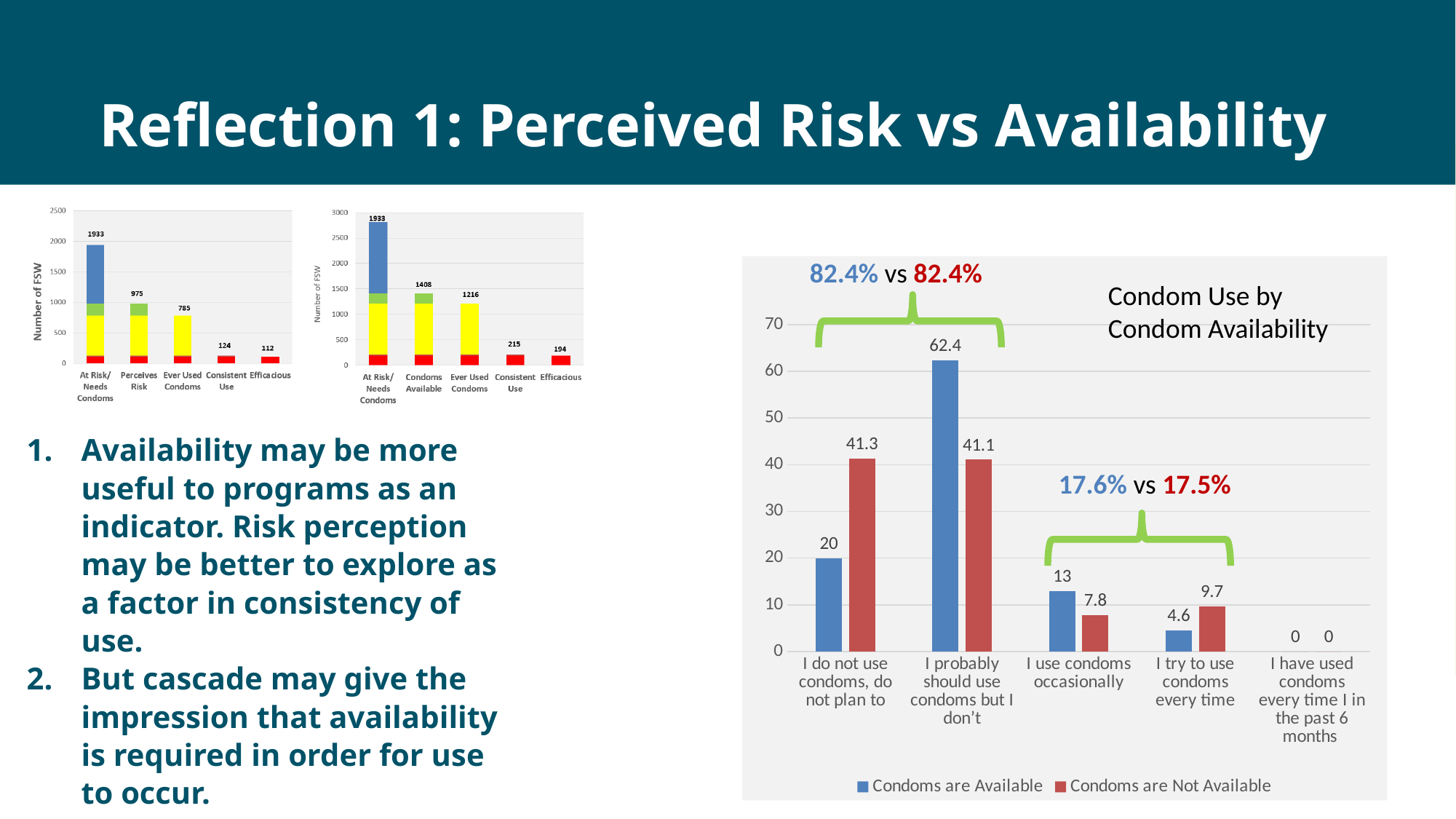
In the chart titled 'Condom Use by Condom Availability', for 'I try to use condoms every time', which series has the larger value? Condoms are Not Available In the chart titled 'Condom Use by Condom Availability', which category has the highest value in the 'Condoms are Available' series? I probably should use condoms but I don't In the chart titled 'Condom Use by Condom Availability', what is the difference between the 'Condoms are Available' and 'Condoms are Not Available' values for 'I use condoms occasionally'? 5.2 In the second small chart from the left at the top of the slide, what is the total labelled for the 'Condoms Available' bar? 1408 What type of chart is the chart titled 'Condom Use by Condom Availability'? Bar chart In the chart titled 'Condom Use by Condom Availability', how many categories are shown on the x axis? 5 In the chart titled 'Condom Use by Condom Availability', what is the value for 'I do not use condoms, do not plan to' in the 'Condoms are Not Available' series? 41.3 In the small chart at the top left of the slide, which category has the lowest labelled total? Efficacious In the chart titled 'Condom Use by Condom Availability', what is the value for 'I probably should use condoms but I don't' in the 'Condoms are Available' series? 62.4 In the chart titled 'Condom Use by Condom Availability', how many series does the legend list? 2 In the second small chart from the left at the top of the slide, what is the difference between the labelled totals for 'Ever Used Condoms' and 'Consistent Use'? 1001 In the small chart at the top left of the slide, what is the total labelled for the 'Perceives Risk' bar? 975